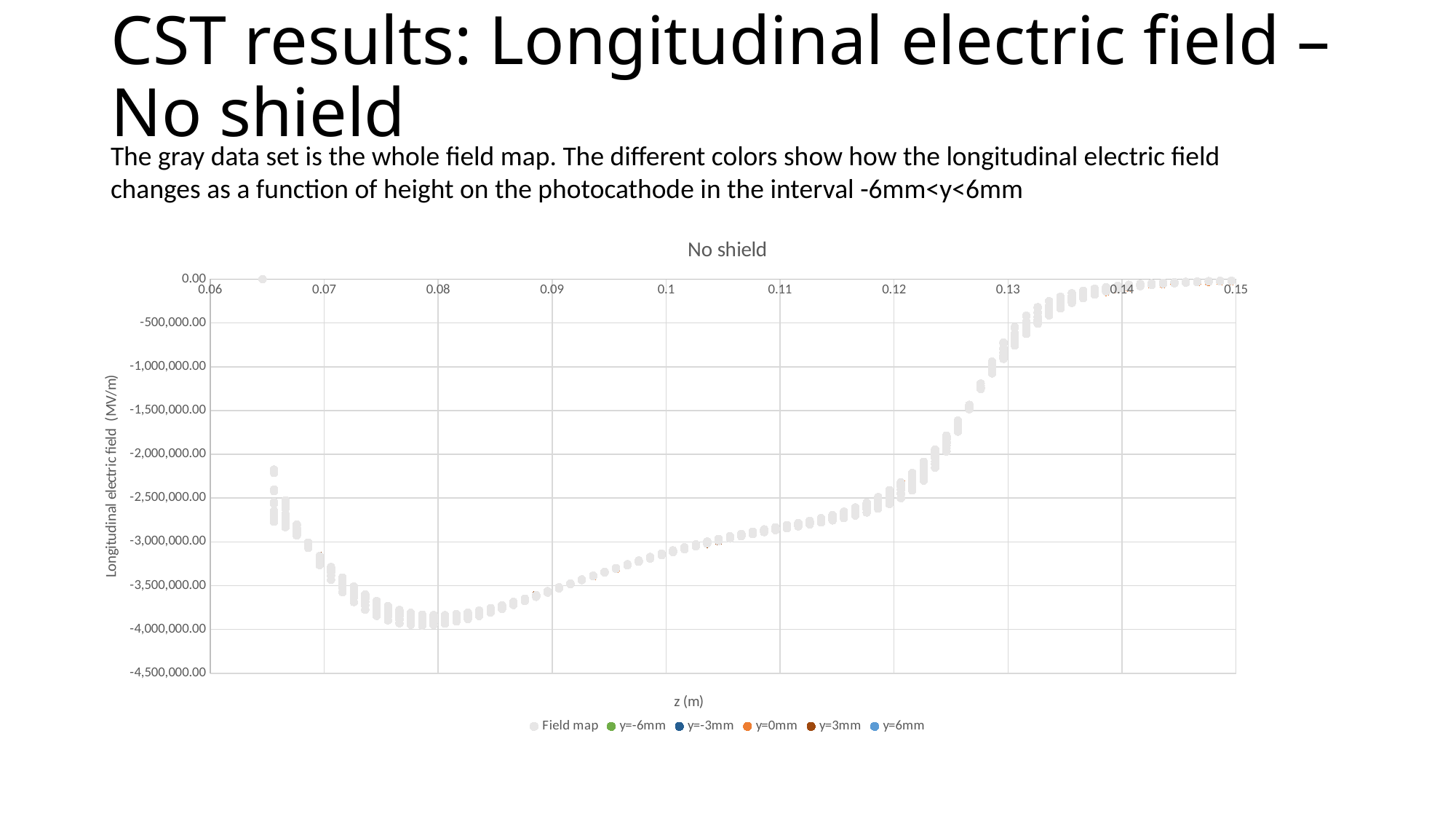
Is the field map value at z = 0.14 greater or less than -500,000.00? greater Which legend entry corresponds to the gray data set? Field map Do the field map values rise or fall as z increases from 0.08 to 0.15? rise What kind of chart is shown on the slide? scatter chart What is the label of the y axis? Longitudinal electric field (MV/m) How many series does the chart legend list? 6 What is the label of the x axis? z (m) What is the lowest value shown on the y axis? -4,500,000.00 Between which two x-axis ticks does the field map reach its most negative value? 0.07 and 0.08 Is the field map value at z = 0.11 greater or less than -3,000,000.00? greater Is the field map value at z = 0.1 greater or less than -3,000,000.00? less What is the title of the chart? No shield